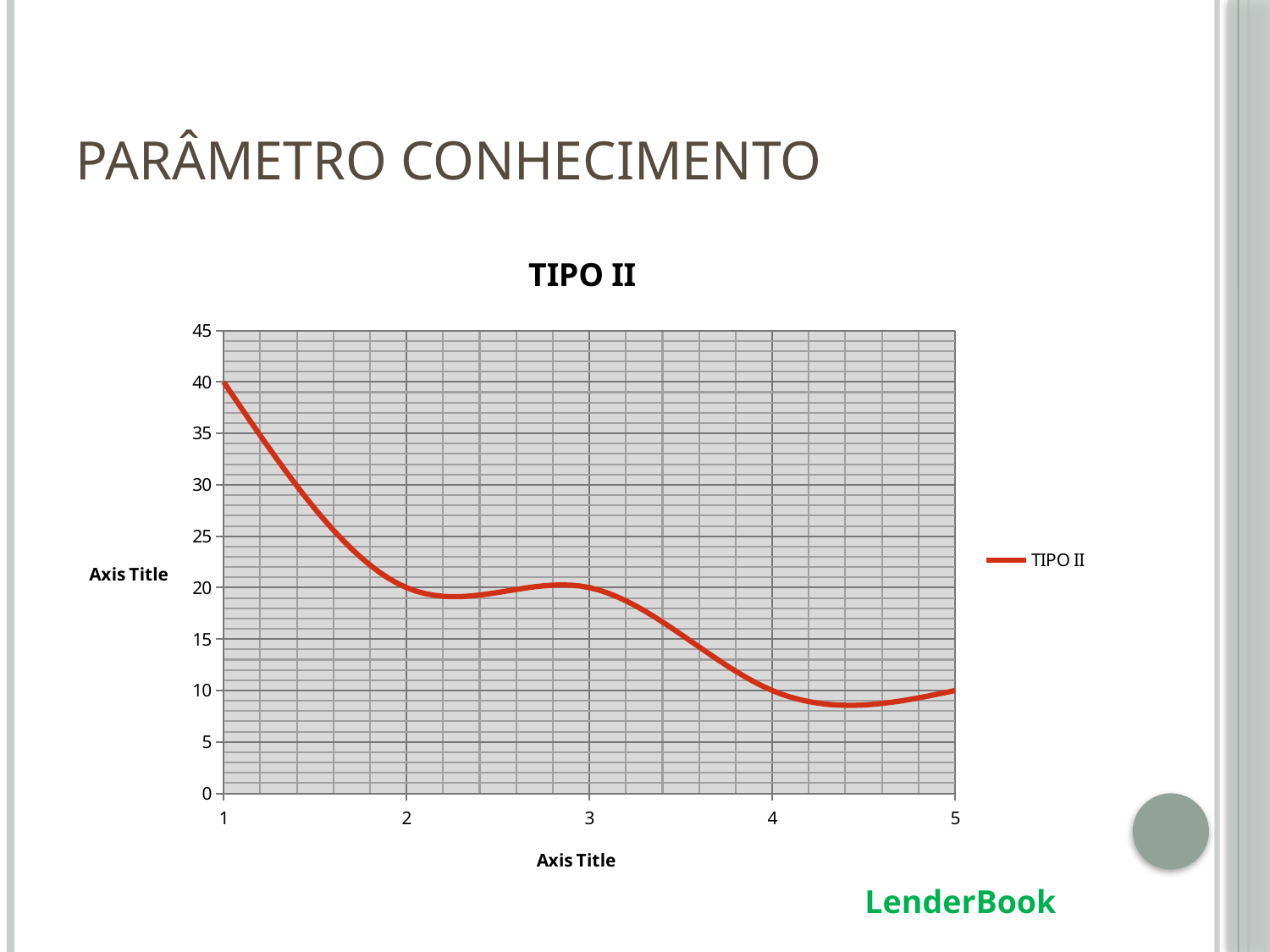
What is the value of TIPO II at x = 4? 10 How many points are plotted along the x axis? 5 How many series does the legend list? 1 What is the value of TIPO II at x = 5? 10 What is the title of the chart? TIPO II At which x value is TIPO II highest? 1 Which is larger, the value of TIPO II at x = 1 or at x = 4? x = 1 Is the value of TIPO II at x = 3 greater or less than 15? greater What kind of chart is shown on the slide? line chart What is the value of TIPO II at x = 1? 40 Overall, do the values of TIPO II rise or fall from x = 1 to x = 5? fall Is the value of TIPO II at x = 2 greater or less than 25? less